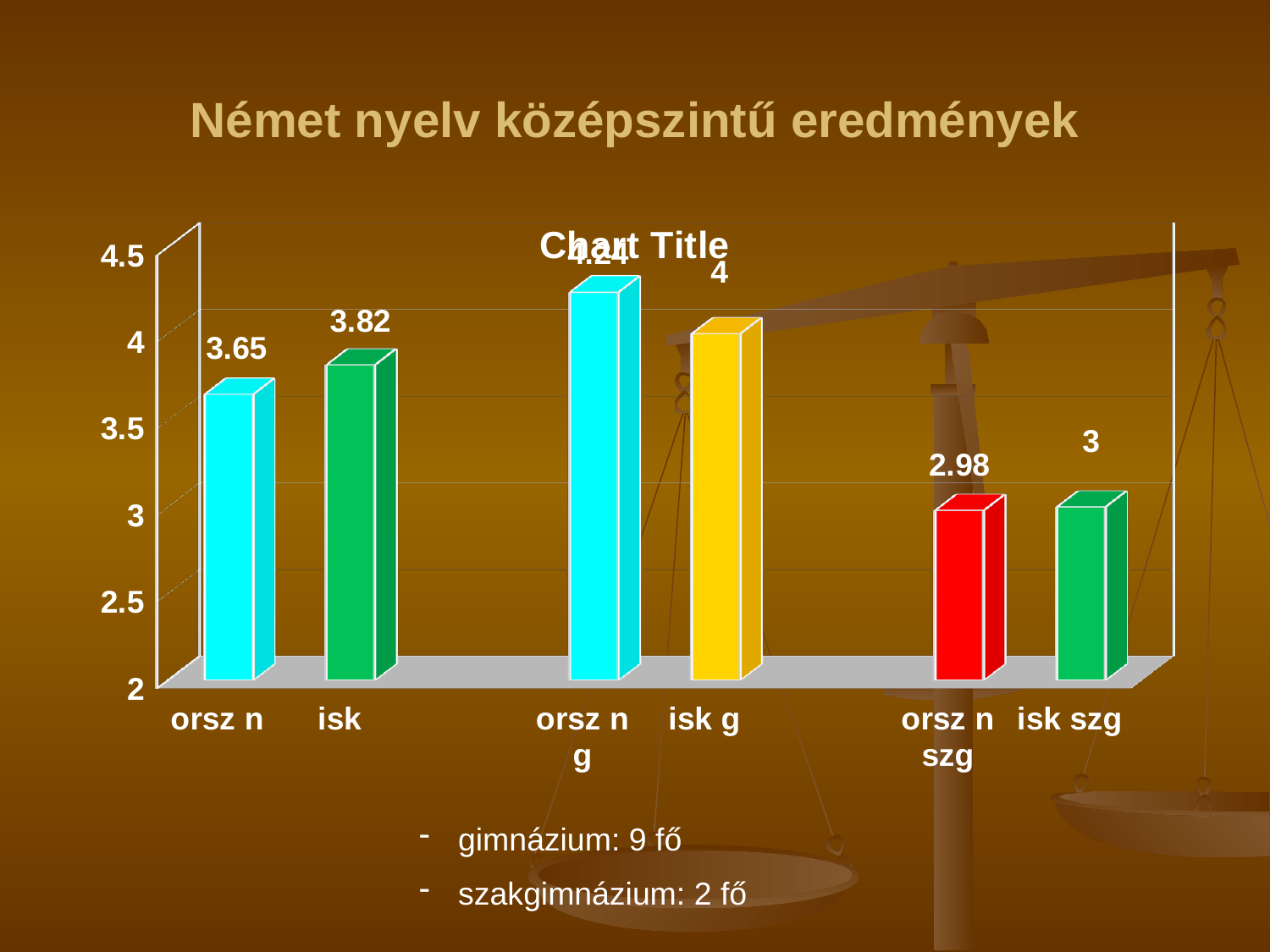
What is the value for orsz n szg? 2.98 What is the value for orsz n? 3.65 Which category has the highest value? orsz n g How many categories are shown on the x axis? 6 Which is larger, the value for isk g or the value for isk szg? isk g Which category has the lowest value? orsz n szg What is the value for isk szg? 3 What is the value for isk g? 4 Is the value for orsz n g greater or less than 4? greater What is the value for isk? 3.82 What kind of chart is shown on the slide? bar chart What is the difference between the values for isk and orsz n? 0.17